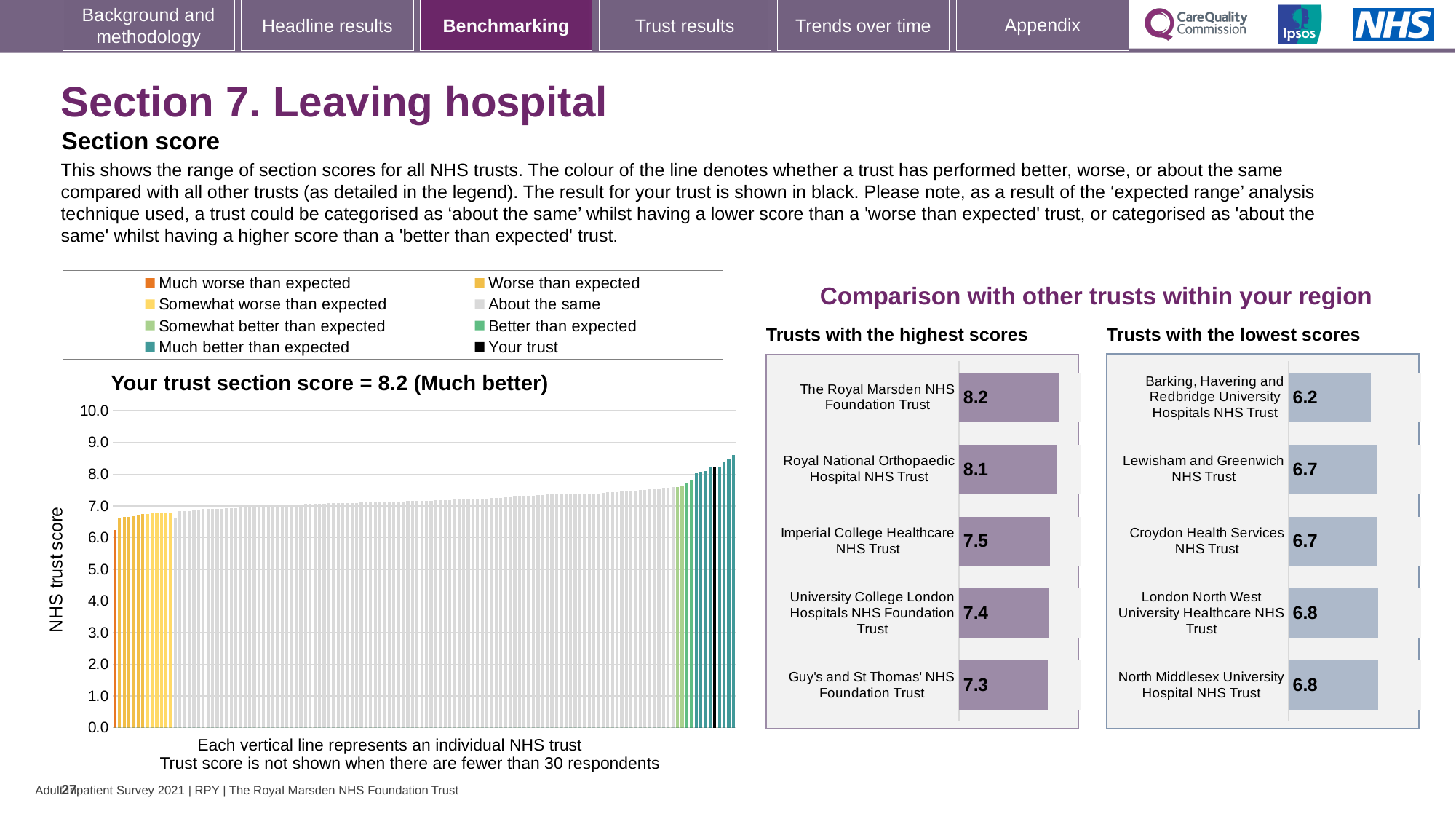
How many entries does the legend above the 'Your trust section score' chart list? 8 In the 'Trusts with the highest scores' chart, which has the larger score: Imperial College Healthcare NHS Trust or University College London Hospitals NHS Foundation Trust? Imperial College Healthcare NHS Trust In the 'Trusts with the lowest scores' chart, what is the score for Lewisham and Greenwich NHS Trust? 6.7 How many trusts are shown in the 'Trusts with the lowest scores' chart? 5 In the 'Trusts with the lowest scores' chart, what is the difference between the scores of North Middlesex University Hospital NHS Trust and Barking, Havering and Redbridge University Hospitals NHS Trust? 0.6 In the 'Trusts with the highest scores' chart, what is the score for Guy's and St Thomas' NHS Foundation Trust? 7.3 In the 'Trusts with the highest scores' chart, which trust has the highest score? The Royal Marsden NHS Foundation Trust What kind of chart is the 'Your trust section score' chart on the left? Bar chart In the 'Trusts with the highest scores' chart, what is the difference between the scores of The Royal Marsden NHS Foundation Trust and Guy's and St Thomas' NHS Foundation Trust? 0.9 In the 'Trusts with the lowest scores' chart, which trust has the lowest score? Barking, Havering and Redbridge University Hospitals NHS Trust In the 'Your trust section score' chart on the left, do the trust scores rise or fall from left to right? Rise In the 'Trusts with the highest scores' chart, what is the score for Imperial College Healthcare NHS Trust? 7.5